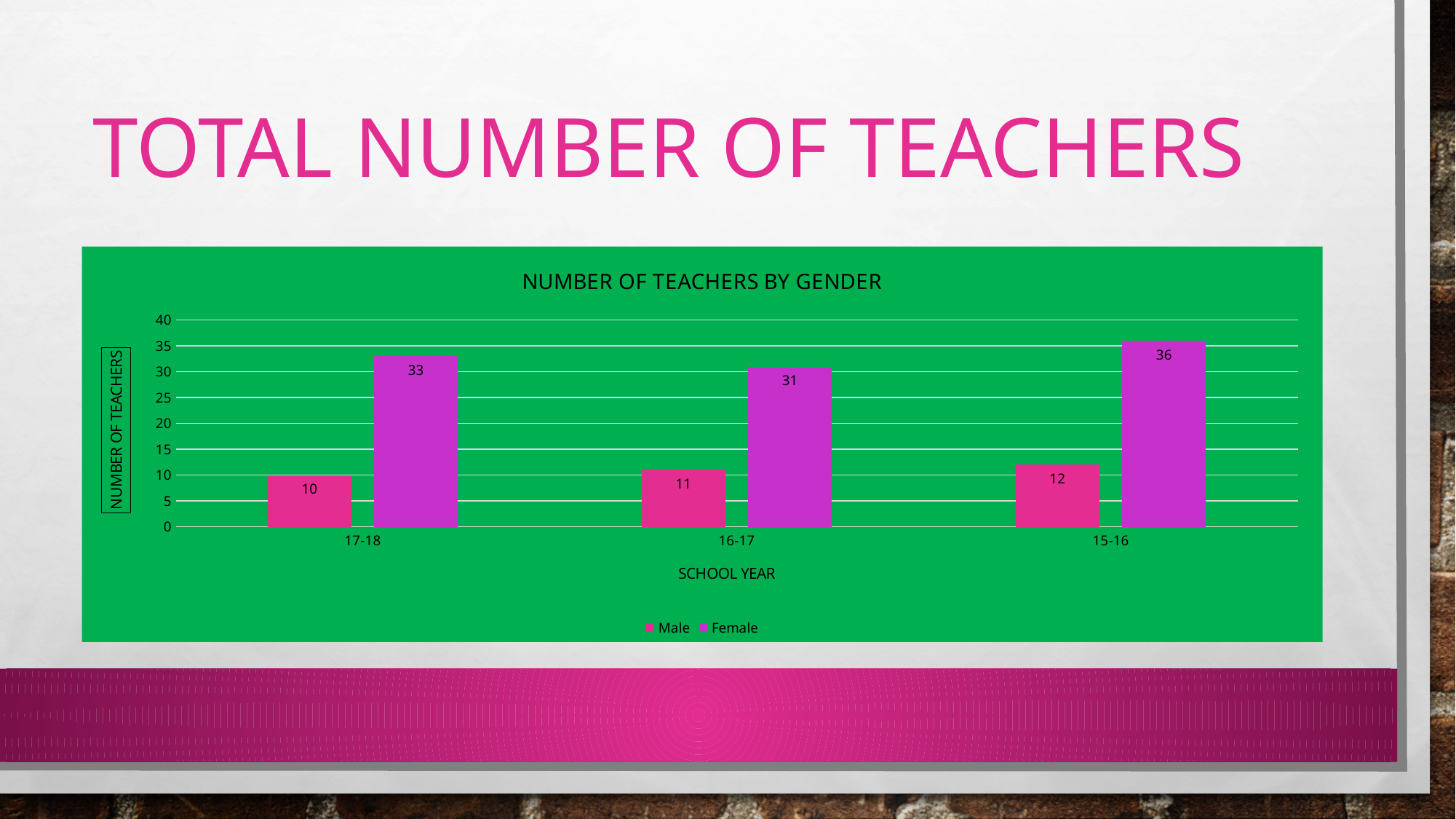
What is the difference between the number of Female and Male teachers in school year 17-18? 23 Which school year has the highest number of Female teachers? 15-16 Which school year has the lowest number of Male teachers? 17-18 What is the number of Male teachers in school year 17-18? 10 Is the number of Female teachers in 15-16 greater or less than 35? greater How many school years are shown on the x axis? 3 What is the number of Female teachers in school year 16-17? 31 Which is larger: the number of Female teachers in 16-17 or in 15-16? 15-16 How many series does the legend list? 2 What is the number of Female teachers in school year 15-16? 36 What kind of chart is shown on the slide? Bar chart What is the title of the chart? NUMBER OF TEACHERS BY GENDER